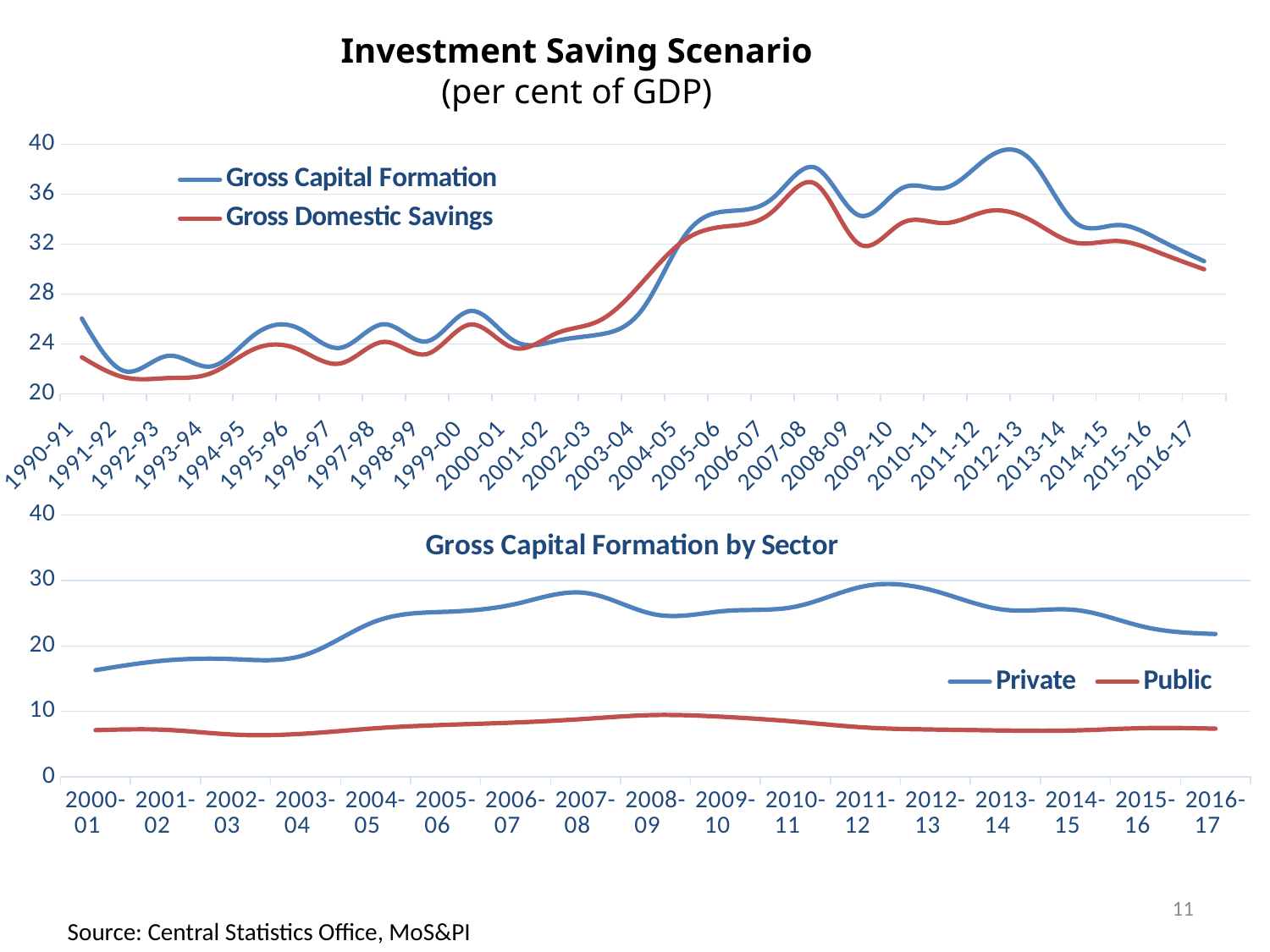
In the top chart 'Investment Saving Scenario', how many series does the legend list? 2 In the top chart 'Investment Saving Scenario', does Gross Capital Formation rise or fall from 2012-13 to 2016-17? fall In the bottom chart 'Gross Capital Formation by Sector', is the value for Private in 2000-01 greater or less than 20? less In the top chart 'Investment Saving Scenario', is the value of Gross Capital Formation in 2012-13 greater or less than 36? greater In the bottom chart 'Gross Capital Formation by Sector', which series is higher in 2011-12, Private or Public? Private In the top chart 'Investment Saving Scenario', which series is higher in 2008-09, Gross Capital Formation or Gross Domestic Savings? Gross Capital Formation In the top chart 'Investment Saving Scenario', is the value of Gross Domestic Savings in 1992-93 greater or less than 24? less What kind of chart is the top chart titled 'Investment Saving Scenario'? line chart In the bottom chart 'Gross Capital Formation by Sector', how many years are shown on the x axis? 17 What kind of chart is the bottom chart titled 'Gross Capital Formation by Sector'? line chart In the top chart 'Investment Saving Scenario', how many years are shown on the x axis? 27